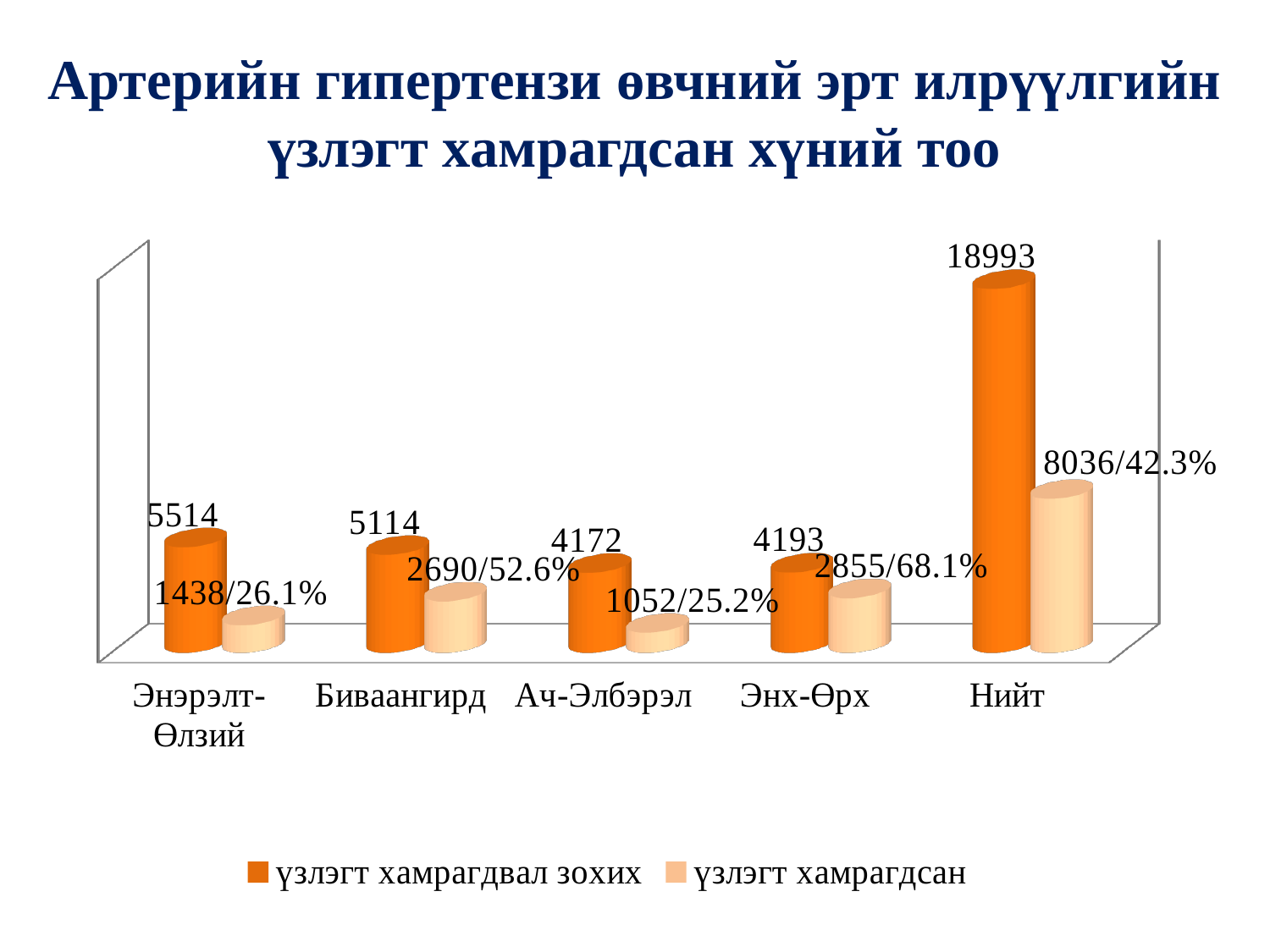
Which is larger: the "үзлэгт хамрагдсан" count for Биваангирд or for Энх-Өрх? Энх-Өрх How many categories are shown on the x axis? 5 What is the data label for "үзлэгт хамрагдсан" for Энх-Өрх? 2855/68.1% What is the value of "үзлэгт хамрагдвал зохих" for Нийт? 18993 How many series does the legend list? 2 Which category has the lowest value for "үзлэгт хамрагдвал зохих"? Ач-Элбэрэл What is the percentage shown in the "үзлэгт хамрагдсан" label for Ач-Элбэрэл? 25.2% What is the difference between the "үзлэгт хамрагдвал зохих" values for Энэрэлт-Өлзий and Биваангирд? 400 What is the data label for "үзлэгт хамрагдсан" for Биваангирд? 2690/52.6% What is the value of "үзлэгт хамрагдвал зохих" for Энэрэлт-Өлзий? 5514 Which category has the highest value for "үзлэгт хамрагдсан"? Нийт What kind of chart is shown on the slide? Bar chart